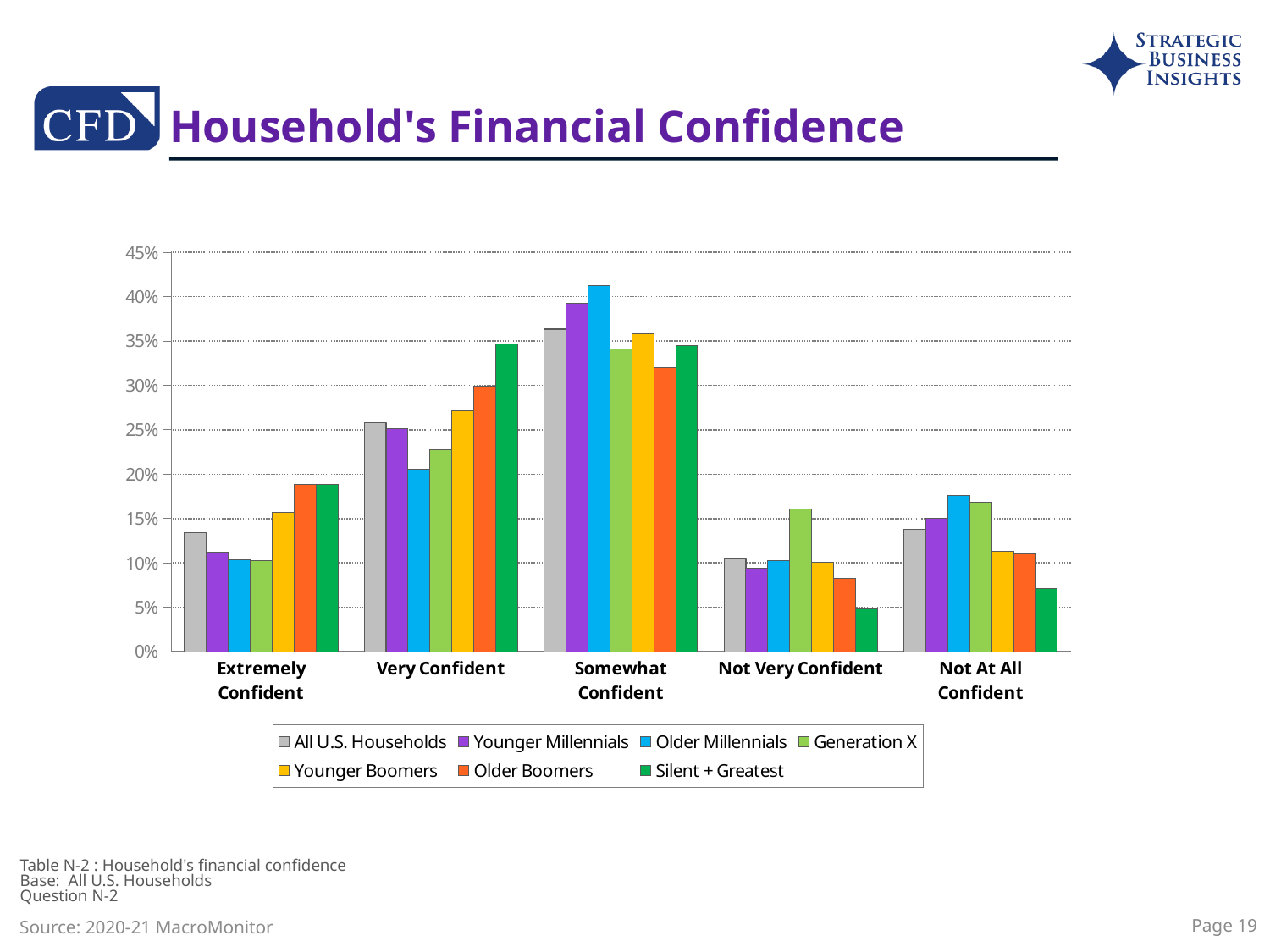
Which group has the lowest value in the Not At All Confident category? Silent + Greatest Is the value for Silent + Greatest in the Very Confident category greater or less than 30%? greater How many series does the legend list? 7 Is the value for Generation X in the Not Very Confident category greater or less than 15%? greater Is the value for Older Millennials in the Somewhat Confident category greater or less than 40%? greater What is the title of the slide's chart? Household's Financial Confidence In the Extremely Confident category, which is larger: Older Boomers or Younger Millennials? Older Boomers Which group has the highest value in the Very Confident category? Silent + Greatest What kind of chart is shown on the slide? Bar chart Which group has the lowest value in the Not Very Confident category? Silent + Greatest How many confidence categories are shown on the x axis? 5 Which group has the highest value in the Somewhat Confident category? Older Millennials